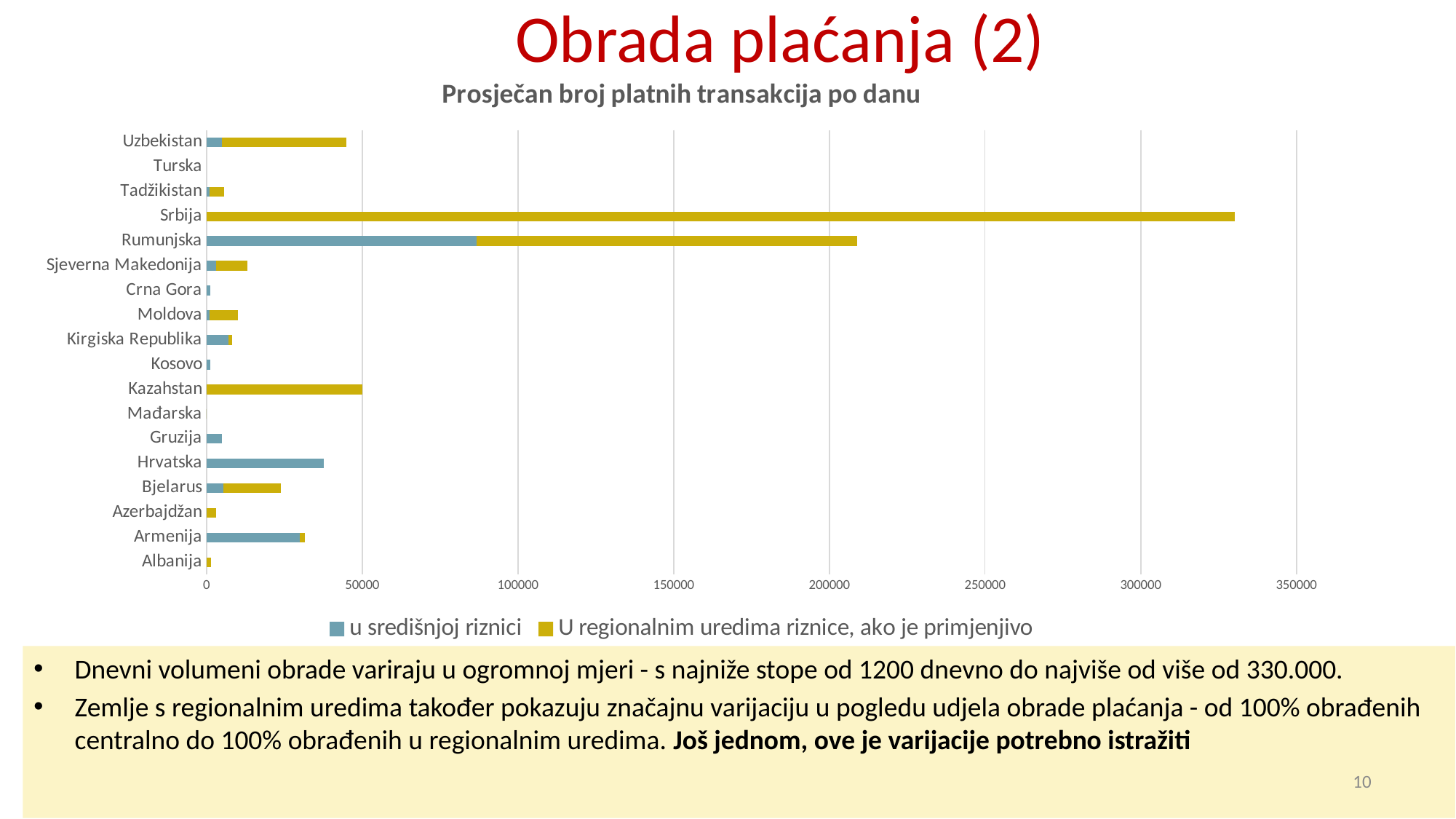
Is the total value for Armenija greater or less than 50000? less What kind of chart is shown on the slide? Stacked bar chart Which has a larger total value, Srbija or Rumunjska? Srbija How many series does the legend list? 2 Which series is shown in blue in the legend? u središnjoj riznici What is the title of the chart? Prosječan broj platnih transakcija po danu How many countries are listed on the vertical axis of the chart? 18 Which has a larger total value, Hrvatska or Bjelarus? Hrvatska Which country has the longest bar in the chart? Srbija Is the total value for Rumunjska greater or less than 200000? greater Is the total value for Srbija greater or less than 300000? greater